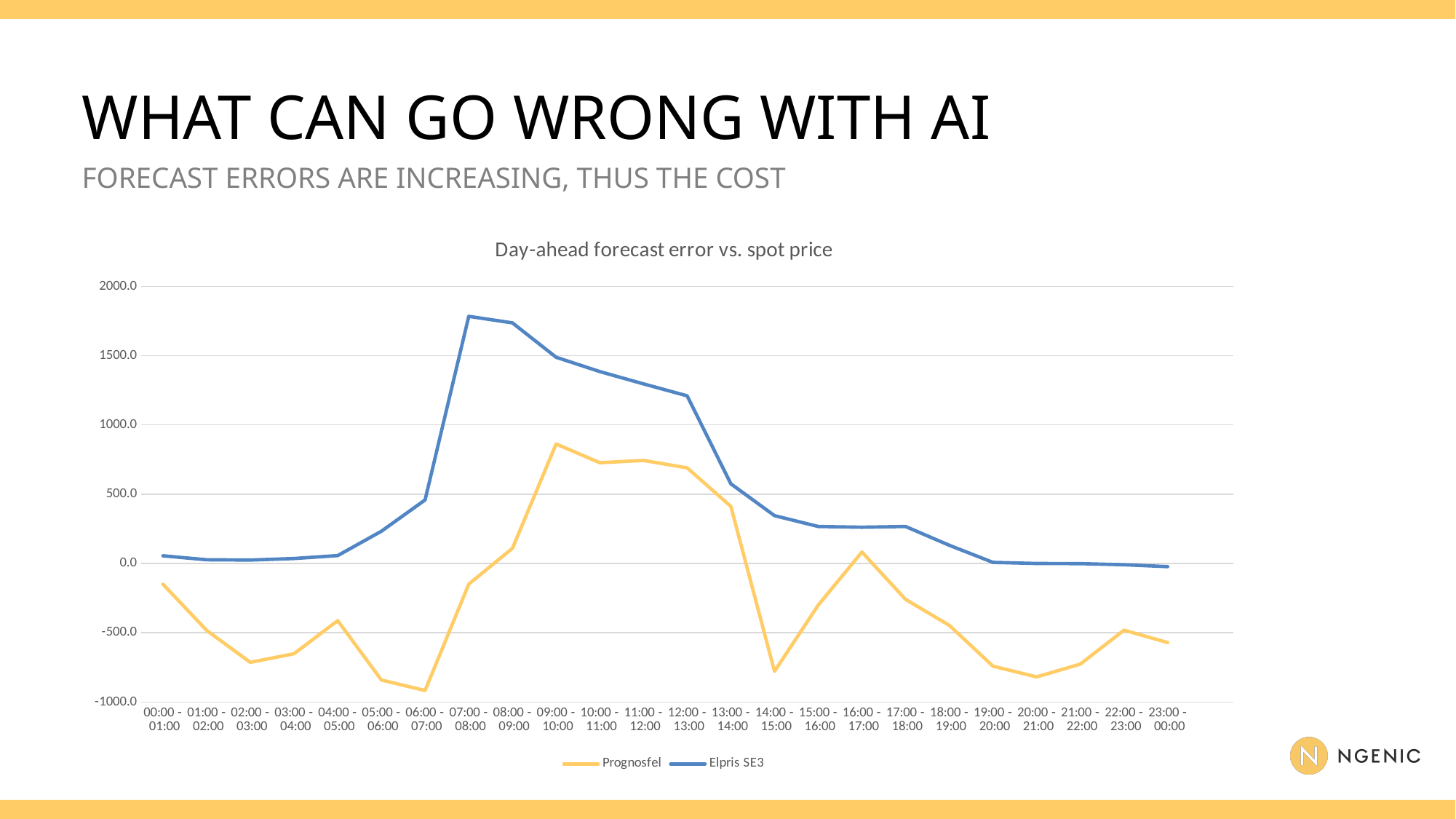
Does the Elpris SE3 line rise or fall from 07:00 - 08:00 to 23:00 - 00:00? Fall Is the value for Prognosfel at 06:00 - 07:00 greater or less than -500.0? less How many series does the legend list? 2 In which hourly interval does Prognosfel reach its highest value? 09:00 - 10:00 What kind of chart is shown on the slide? Line chart In which hourly interval does Prognosfel reach its lowest value? 06:00 - 07:00 Is the value for Elpris SE3 at 07:00 - 08:00 greater or less than 1500.0? greater At 09:00 - 10:00, which series has the larger value, Prognosfel or Elpris SE3? Elpris SE3 How many hourly intervals are shown on the x axis? 24 What is the title of the chart? Day-ahead forecast error vs. spot price Which series is drawn in blue? Elpris SE3 In which hourly interval does Elpris SE3 reach its highest value? 07:00 - 08:00